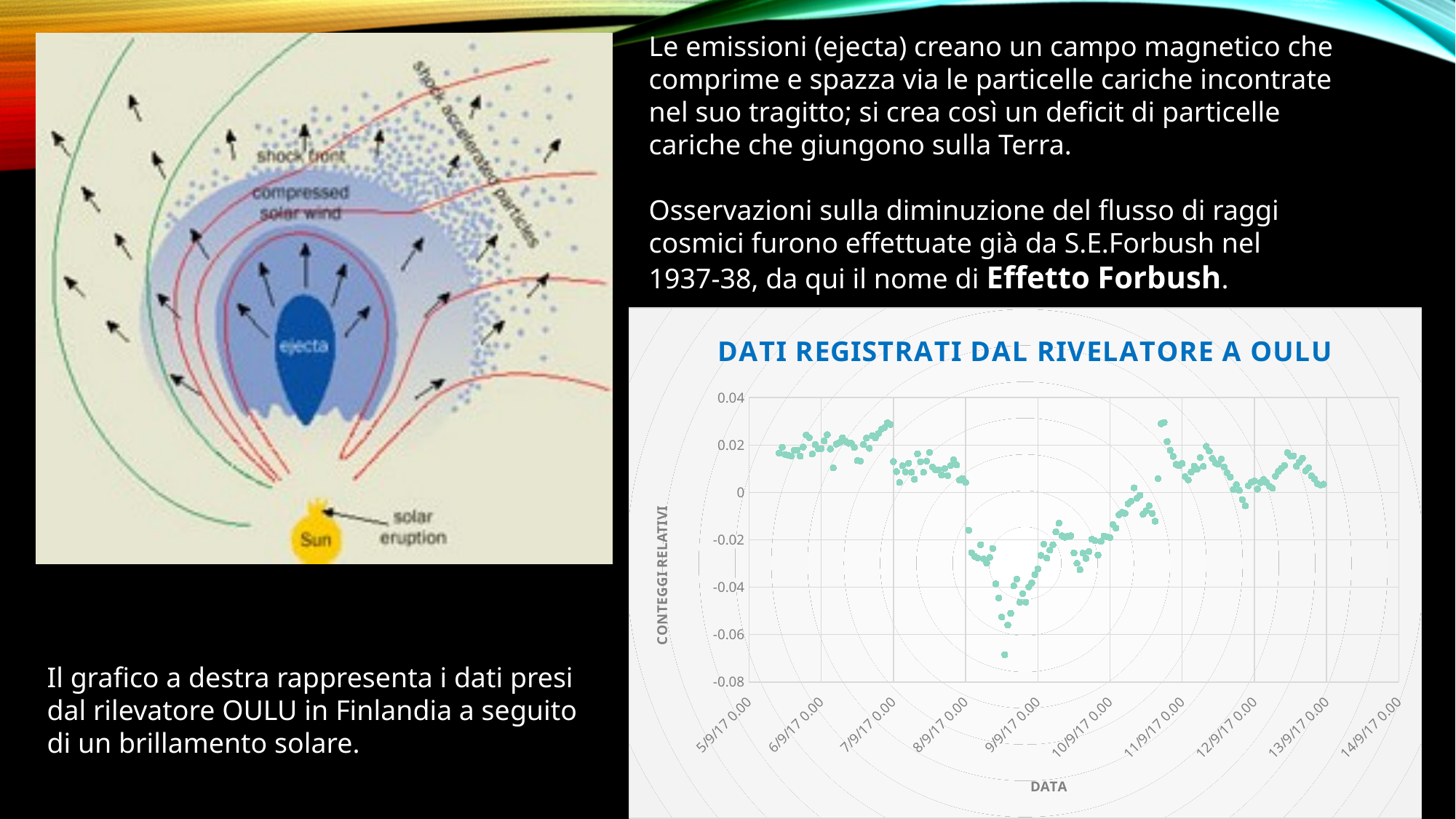
Are the plotted values around 6/9/17 0.00 greater or less than 0? greater What is the highest value shown on the vertical axis of the chart? 0.04 Are the plotted values around 11/9/17 0.00 greater or less than 0? greater Do the plotted values rise or fall between 9/9/17 0.00 and 11/9/17 0.00? rise Near which date on the x axis does the chart reach its lowest value? 9/9/17 0.00 Are the plotted values around 9/9/17 0.00 greater or less than -0.02? less Do the plotted values rise or fall between 7/9/17 0.00 and 9/9/17 0.00? fall What kind of chart is shown on the slide? scatter chart What is the title of the chart? DATI REGISTRATI DAL RIVELATORE A OULU Which is larger: the values plotted around 7/9/17 0.00 or the values plotted around 9/9/17 0.00? 7/9/17 0.00 What is the label of the vertical axis of the chart? CONTEGGI RELATIVI